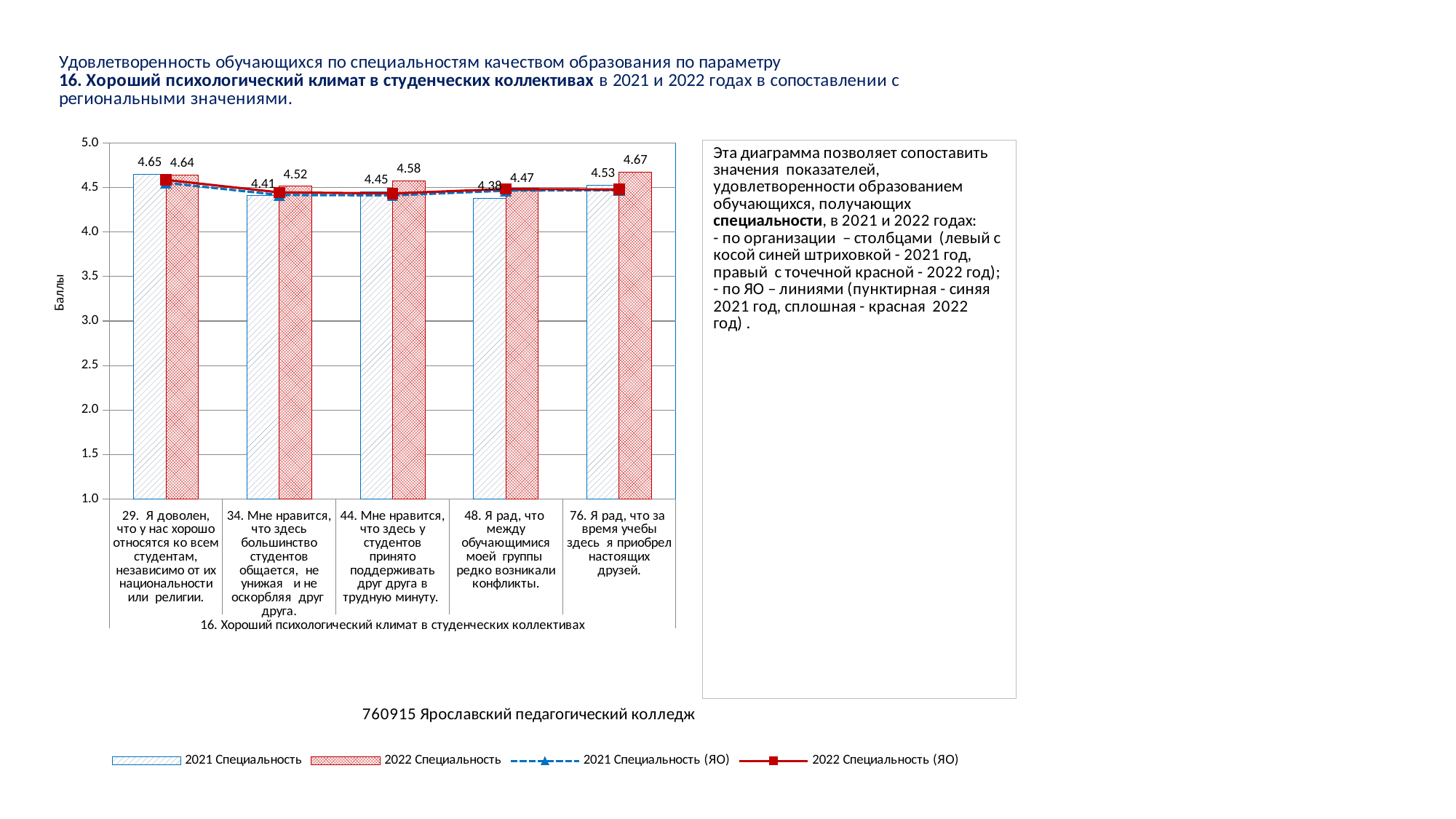
For item 48, which is larger: the 2021 Специальность value or the 2022 Специальность value? 2022 Специальность What is the difference between the 2022 and 2021 Специальность values for item 34? 0.11 What is the 2022 Специальность value for item 44 (Мне нравится, что здесь у студентов принято поддерживать друг друга)? 4.58 Which item has the lowest 2021 Специальность value? 48. Я рад, что между обучающимися моей группы редко возникали конфликты. How many series does the legend list? 4 Which item has the highest 2022 Специальность value? 76. Я рад, что за время учебы здесь я приобрел настоящих друзей. What kind of chart is this? Bar chart with line series What is the 2021 Специальность value for item 29 (Я доволен, что у нас хорошо относятся ко всем студентам)? 4.65 How many items (categories) are shown on the x axis? 5 What is the 2022 Специальность value for item 76 (Я рад, что за время учебы здесь я приобрел настоящих друзей)? 4.67 What is the label of the vertical axis? Баллы Is the 2021 Специальность value for item 34 greater or less than 4.5? less